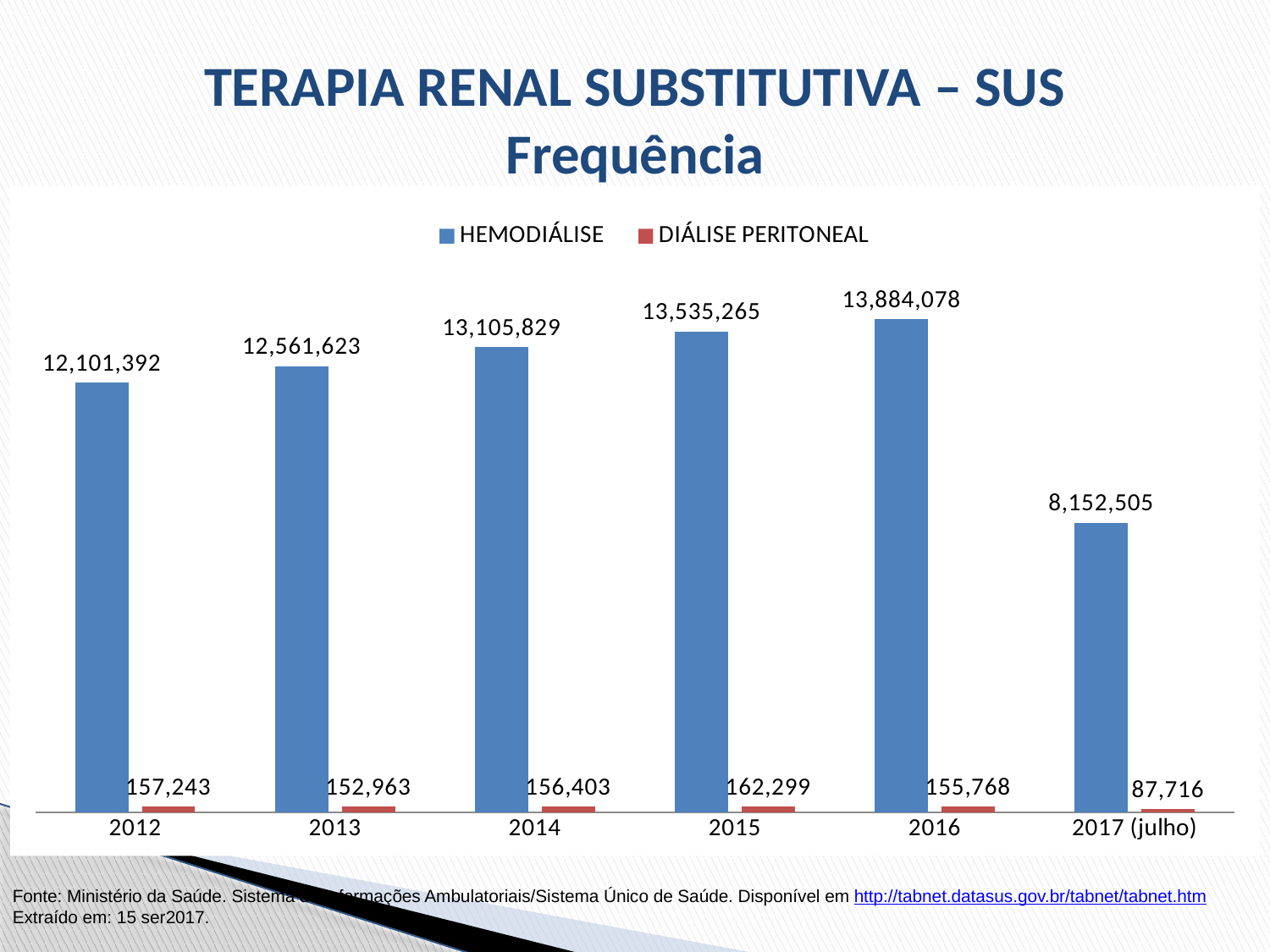
What is the DIÁLISE PERITONEAL value for 2015? 162,299 How many categories are shown on the x axis? 6 Which year has the highest HEMODIÁLISE value? 2016 How many series does the legend list? 2 Which is larger, the HEMODIÁLISE value for 2013 or for 2014? 2014 What is the difference between the HEMODIÁLISE values for 2016 and 2015? 348,813 What is the HEMODIÁLISE value for 2014? 13,105,829 What is the difference between the DIÁLISE PERITONEAL values for 2015 and 2016? 6,531 What is the HEMODIÁLISE value for 2017 (julho)? 8,152,505 Which category has the lowest DIÁLISE PERITONEAL value? 2017 (julho) Does the HEMODIÁLISE value rise or fall from 2012 to 2016? rise Which year has the highest DIÁLISE PERITONEAL value? 2015